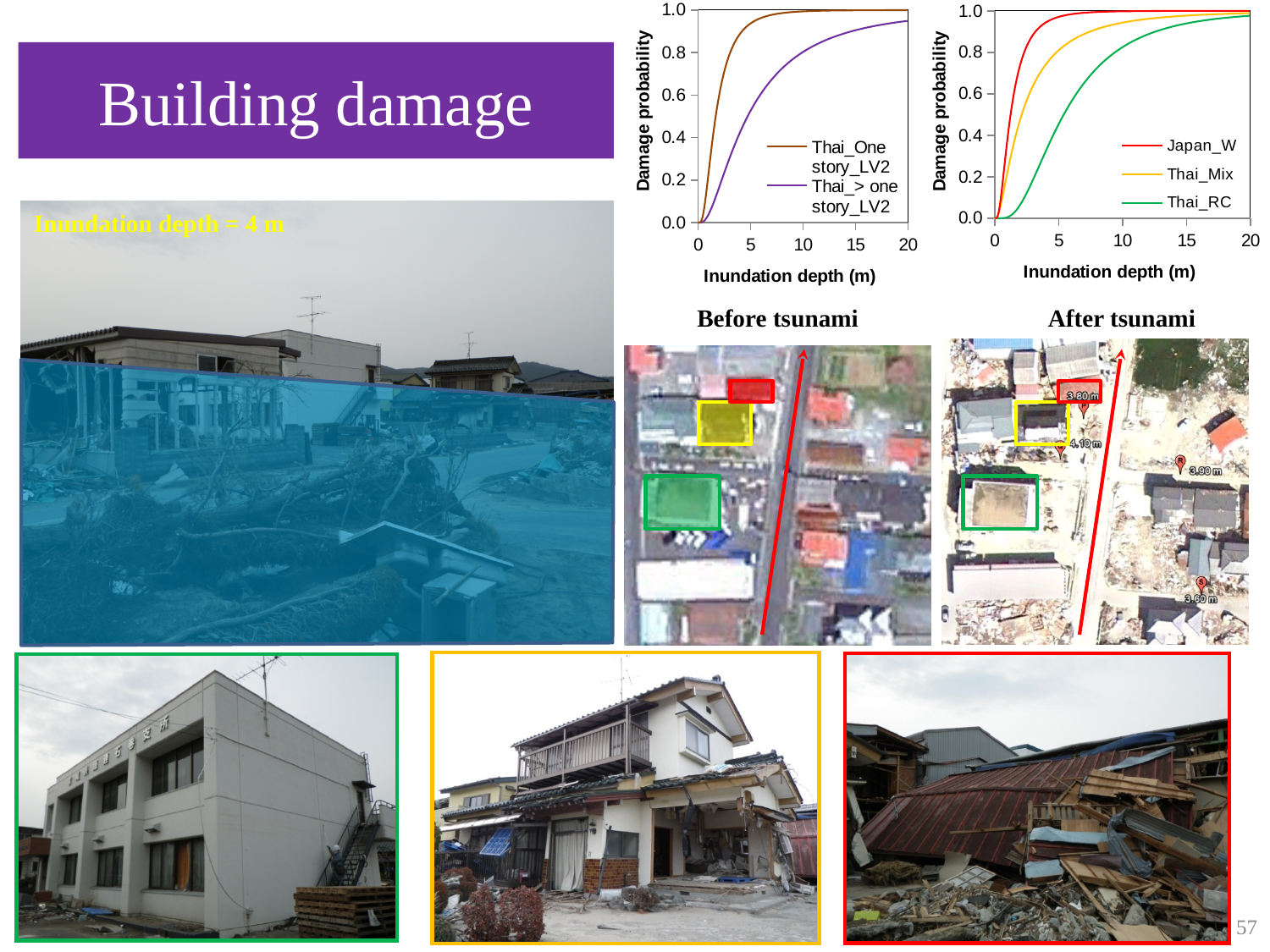
How many series does the legend of the left chart list? 2 What is the x-axis title of the right chart? Inundation depth (m) In the left chart, does the damage probability for Thai_> one story_LV2 rise or fall as inundation depth increases? rise What kind of chart is the left chart (with Thai_One story_LV2 and Thai_> one story_LV2)? line chart In the right chart, is the damage probability for Thai_RC at an inundation depth of 15 m greater or less than 0.8? greater In the right chart, at an inundation depth of 5 m, which series has the higher damage probability, Japan_W or Thai_RC? Japan_W What is the y-axis title of the left chart? Damage probability In the left chart, at an inundation depth of 5 m, which series has the higher damage probability, Thai_One story_LV2 or Thai_> one story_LV2? Thai_One story_LV2 How many series does the legend of the right chart list? 3 What kind of chart is the right chart (with Japan_W, Thai_Mix and Thai_RC)? line chart In the left chart, is the damage probability for Thai_One story_LV2 at an inundation depth of 5 m greater or less than 0.8? greater In the right chart, does the damage probability for Thai_RC rise or fall as inundation depth increases? rise